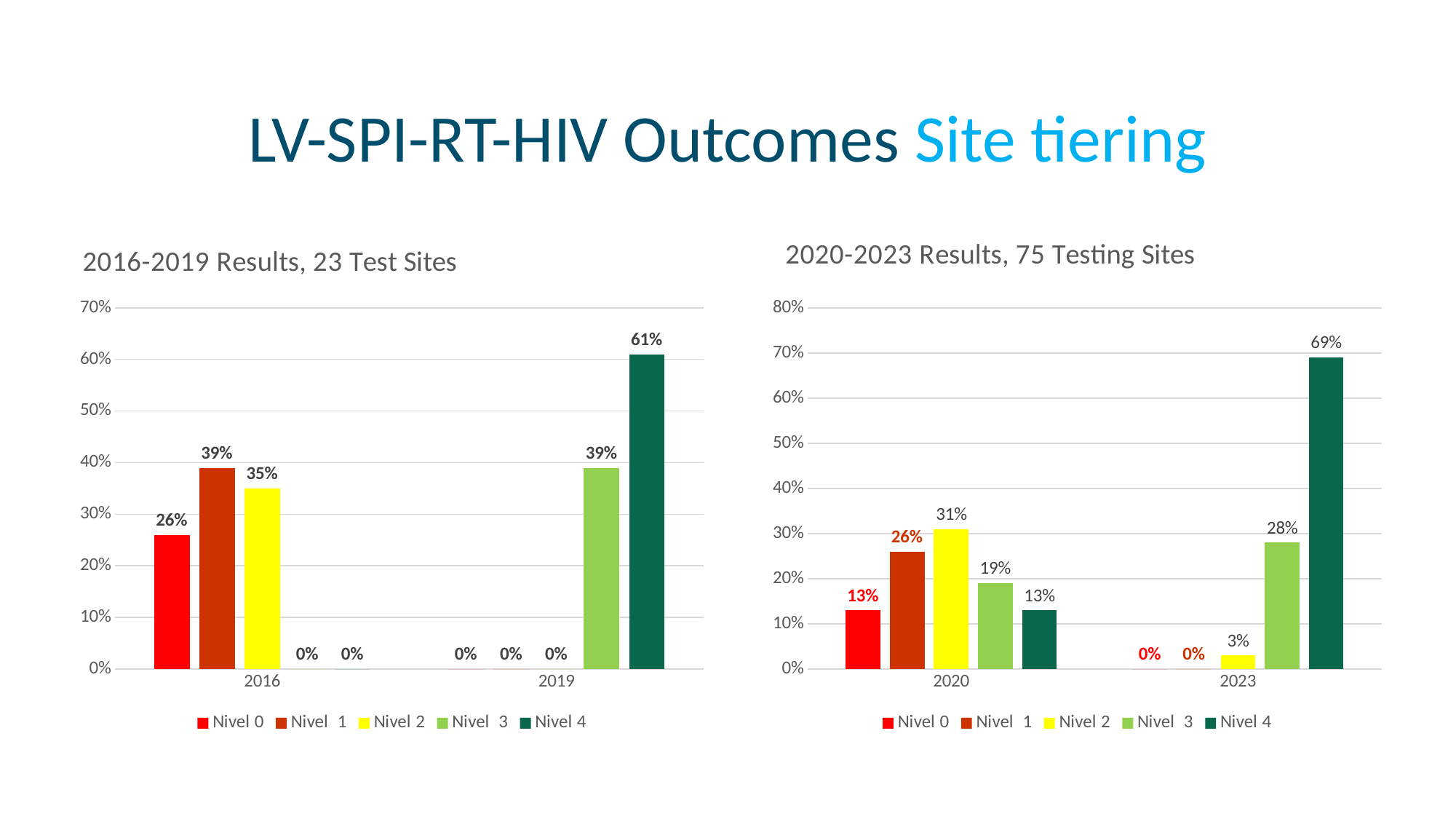
In the '2016-2019 Results, 23 Test Sites' chart, which series has the lowest value in 2016? Nivel 3 and Nivel 4 (both 0%) In the '2020-2023 Results, 75 Testing Sites' chart, which series has the highest value in 2023? Nivel 4 In the '2016-2019 Results, 23 Test Sites' chart, what is the value for Nivel 0 in 2016? 26% In the '2020-2023 Results, 75 Testing Sites' chart, what is the value for Nivel 3 in 2023? 28% In the '2020-2023 Results, 75 Testing Sites' chart, what is the difference between Nivel 4 in 2023 and Nivel 4 in 2020? 56 percentage points In the '2016-2019 Results, 23 Test Sites' chart, which is larger: Nivel 1 in 2016 or Nivel 2 in 2016? Nivel 1 in 2016 In the '2020-2023 Results, 75 Testing Sites' chart, does the value for Nivel 0 rise or fall from 2020 to 2023? Fall In the '2016-2019 Results, 23 Test Sites' chart, what is the value for Nivel 4 in 2019? 61% In the '2020-2023 Results, 75 Testing Sites' chart, what is the value for Nivel 2 in 2020? 31% What kind of chart is the '2016-2019 Results, 23 Test Sites' chart? Bar chart How many year categories are shown on the x axis of the '2016-2019 Results, 23 Test Sites' chart? 2 How many series does the legend of the '2020-2023 Results, 75 Testing Sites' chart list? 5